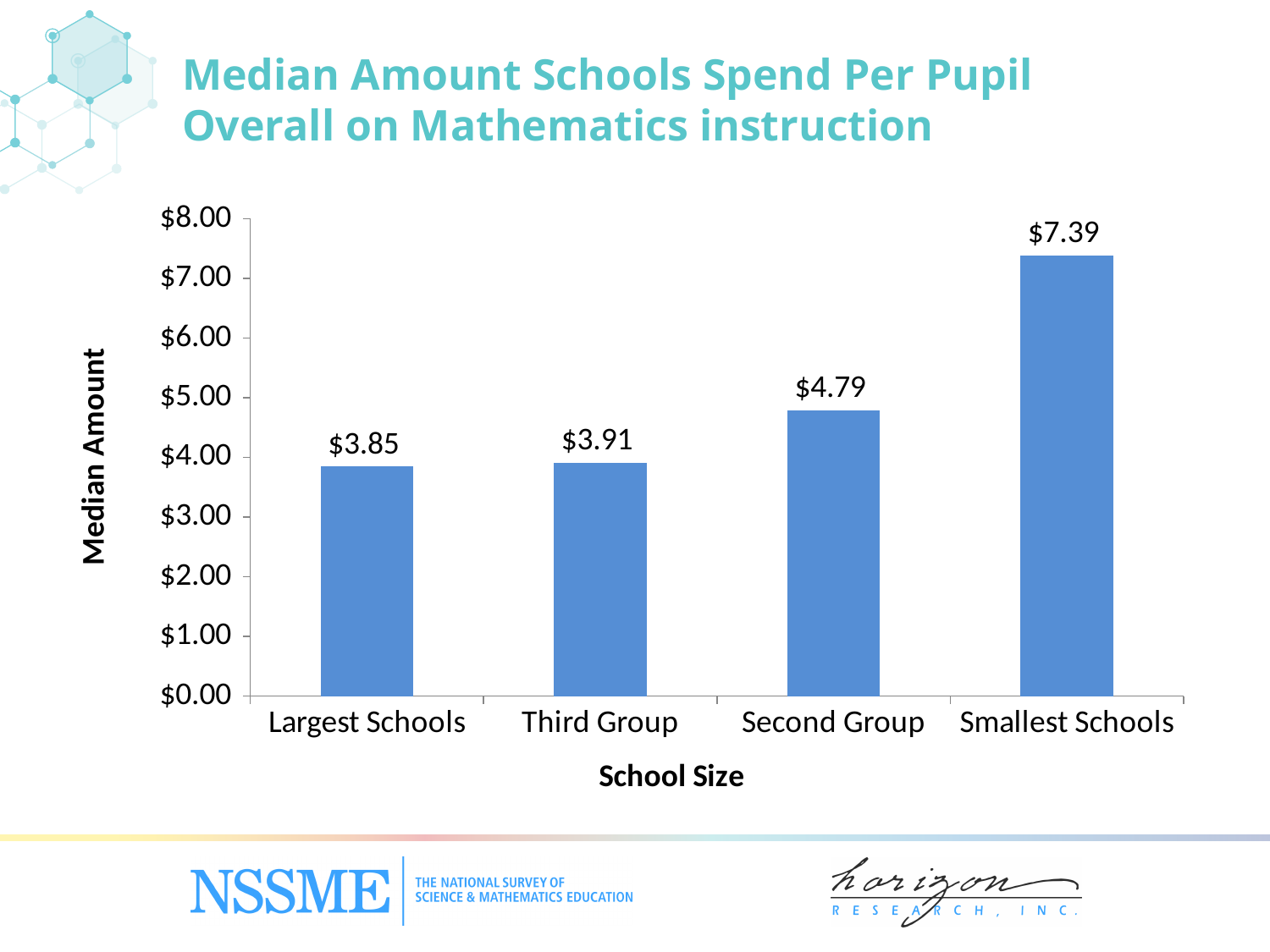
Is the value for Smallest Schools greater or less than $7.00? greater What is the median amount spent per pupil for Second Group? $4.79 What is the median amount spent per pupil for Largest Schools? $3.85 What is the label of the vertical axis? Median Amount What is the difference between the median amounts for Smallest Schools and Largest Schools? $3.54 Which school size category has the lowest median amount? Largest Schools What kind of chart is shown on the slide? Bar chart What is the difference between the median amounts for Second Group and Third Group? $0.88 Which school size category has the highest median amount? Smallest Schools How many school size categories are shown on the chart? 4 Which has a larger median amount, Second Group or Third Group? Second Group What is the median amount spent per pupil for Smallest Schools? $7.39